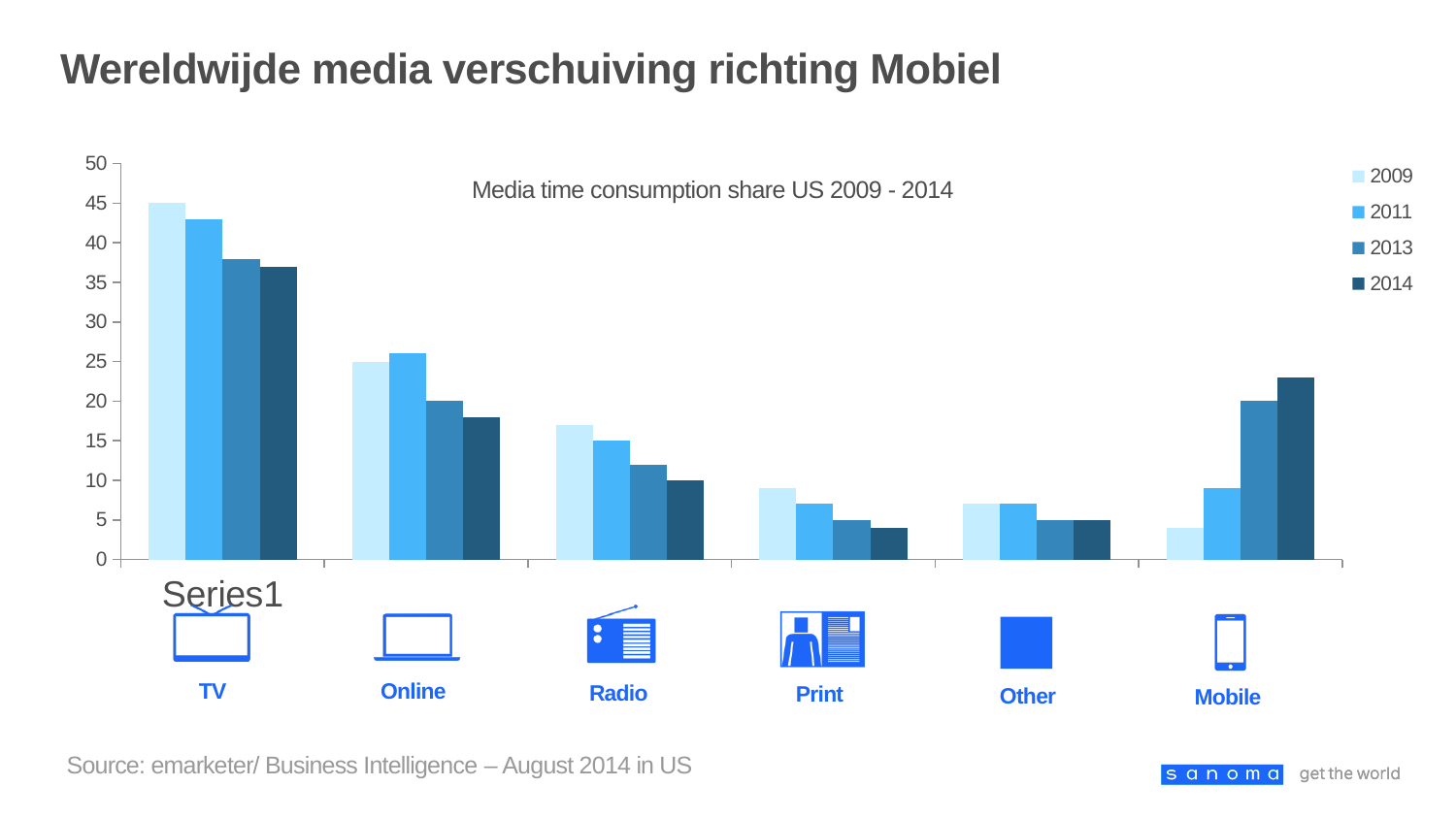
What is the value for Mobile in 2013? 20 What kind of chart is shown on the slide? bar chart How many media categories are shown along the x axis? 6 Is the value for Print in 2009 greater or less than 10? less Is the value for Mobile in 2014 greater or less than 20? greater What is the title of the chart? Media time consumption share US 2009 - 2014 What is the value for TV in 2009? 45 Do the values for TV rise or fall from 2009 to 2014? fall What is the value for Online in 2013? 20 How many series does the legend list? 4 Which category has the highest bar in the chart? TV Which is larger in 2014, the value for Mobile or the value for Online? Mobile